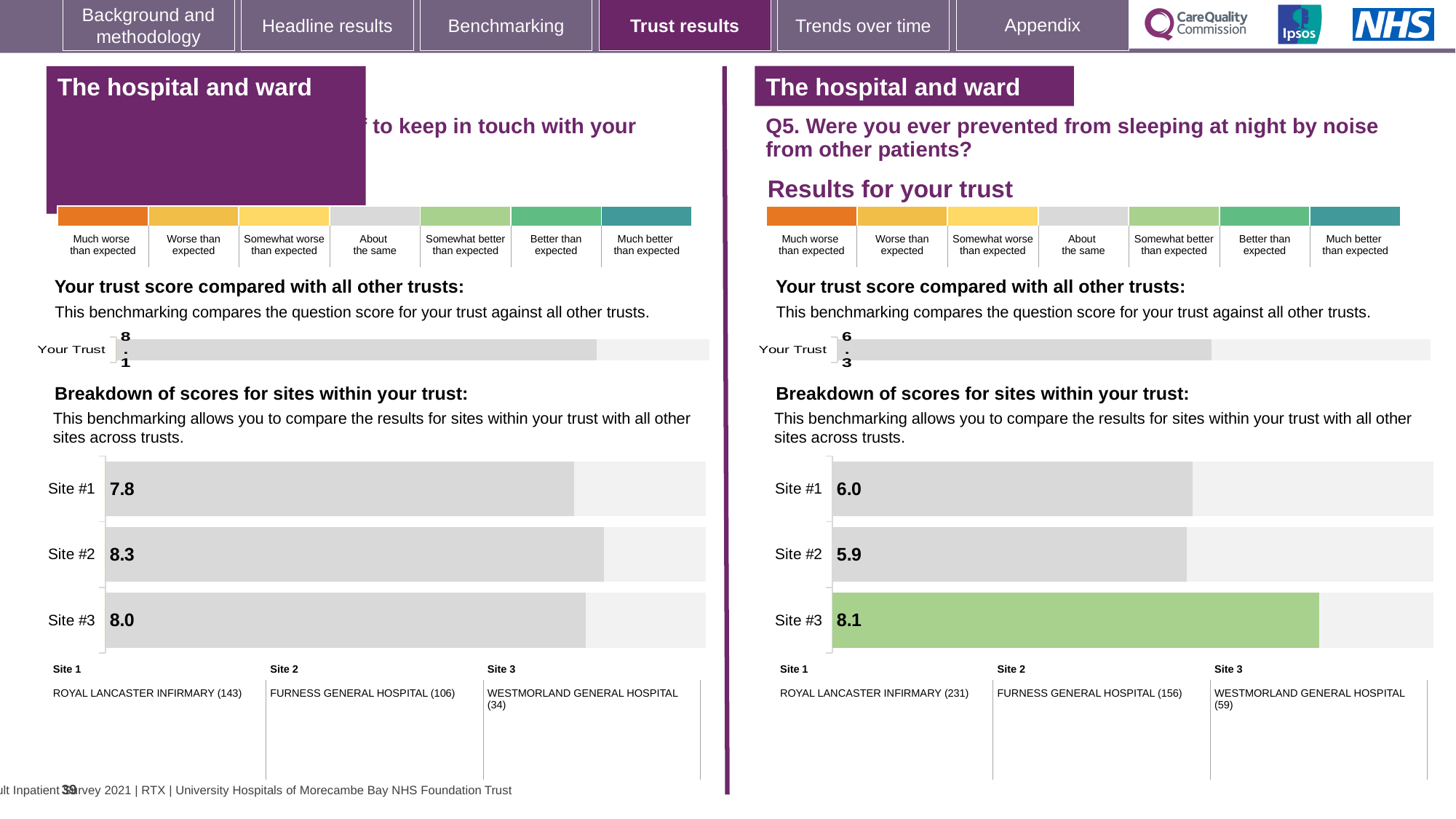
On the right-hand chart (Q5), what is the difference between the scores for Site #3 and Site #1? 2.1 On the left-hand chart, what is the difference between the scores for Site #2 and Site #1? 0.5 On the left-hand chart, what is the 'Your Trust' score? 8.1 How many sites are shown in the site breakdown chart on the right-hand side (Q5)? 3 What type of chart is used for the breakdown of scores for sites on the right-hand side (Q5)? Bar chart On the right-hand chart (Q5), what is the score for Site #1? 6.0 On the right-hand chart (Q5, prevented from sleeping by noise from other patients), what is the score for Site #3? 8.1 On the left-hand chart, what is the score for Site #2? 8.3 On the left-hand chart, which site has the lowest score? Site #1 On the right-hand chart (Q5), which site has the highest score? Site #3 On the right-hand chart (Q5), what is the 'Your Trust' score? 6.3 On the right-hand chart (Q5), which site has the lowest score? Site #2